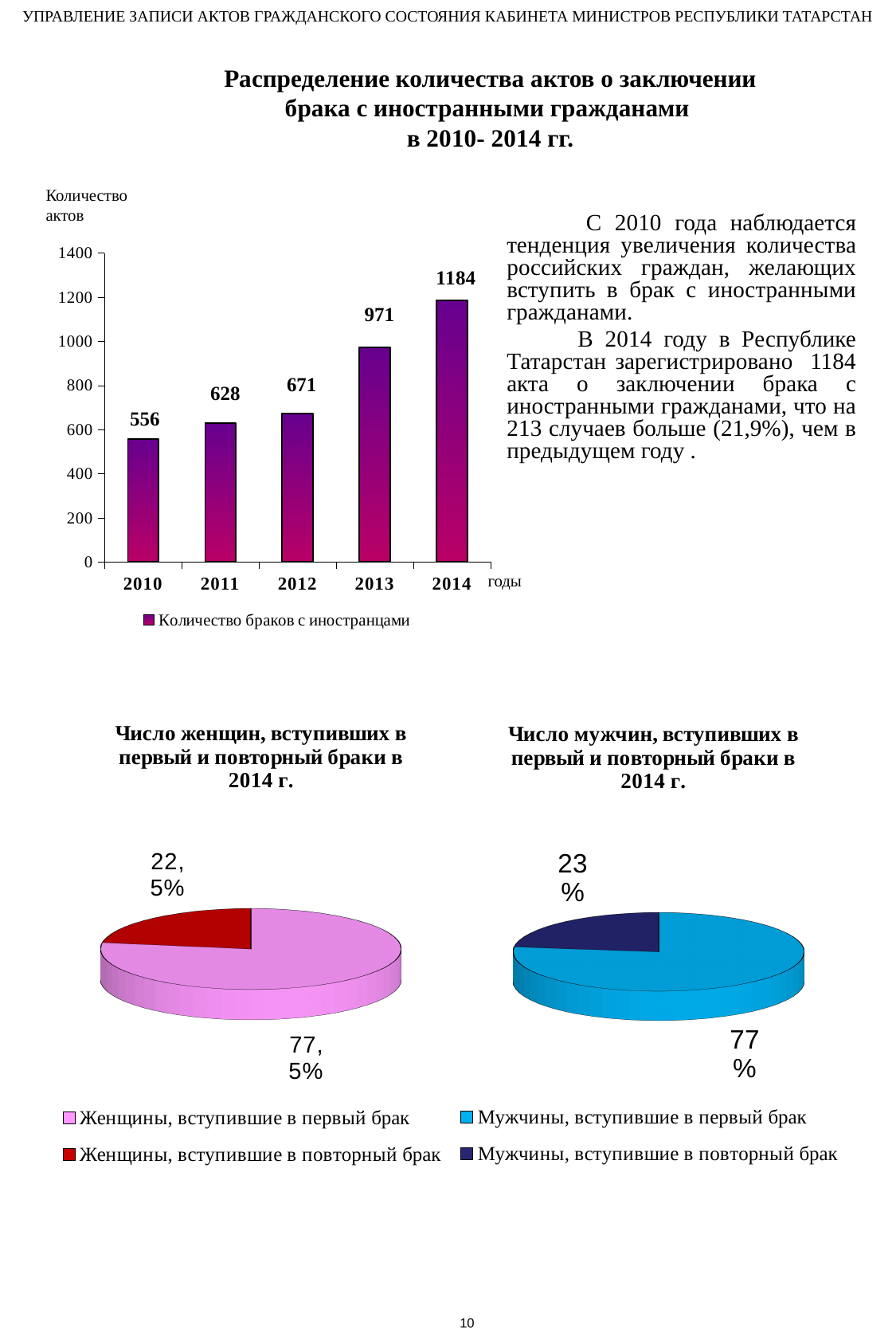
In the bar chart at the top of the slide, which year has the highest value? 2014 In the pie chart 'Число женщин, вступивших в первый и повторный браки в 2014 г.', what share is shown for women entering a repeat marriage (Женщины, вступившие в повторный брак)? 22,5% What kind of chart is the chart at the top of the slide? bar chart In the bar chart at the top of the slide, do the values rise or fall from 2010 to 2014? rise In the bar chart at the top of the slide, which is larger, the value for 2011 or the value for 2012? 2012 In the bar chart at the top of the slide, how many years are shown on the x axis? 5 In the bar chart at the top of the slide, which year has the lowest value? 2010 In the bar chart at the top of the slide, what is the difference between the values for 2014 and 2013? 213 In the pie chart 'Число мужчин, вступивших в первый и повторный браки в 2014 г.', what share is shown for men entering a first marriage (Мужчины, вступившие в первый брак)? 77% How many series does the legend of the bar chart at the top of the slide list? 1 In the bar chart at the top of the slide, what is the value for 2010? 556 In the bar chart 'Распределение количества актов о заключении брака с иностранными гражданами в 2010-2014 гг.', what is the value for 2012? 671